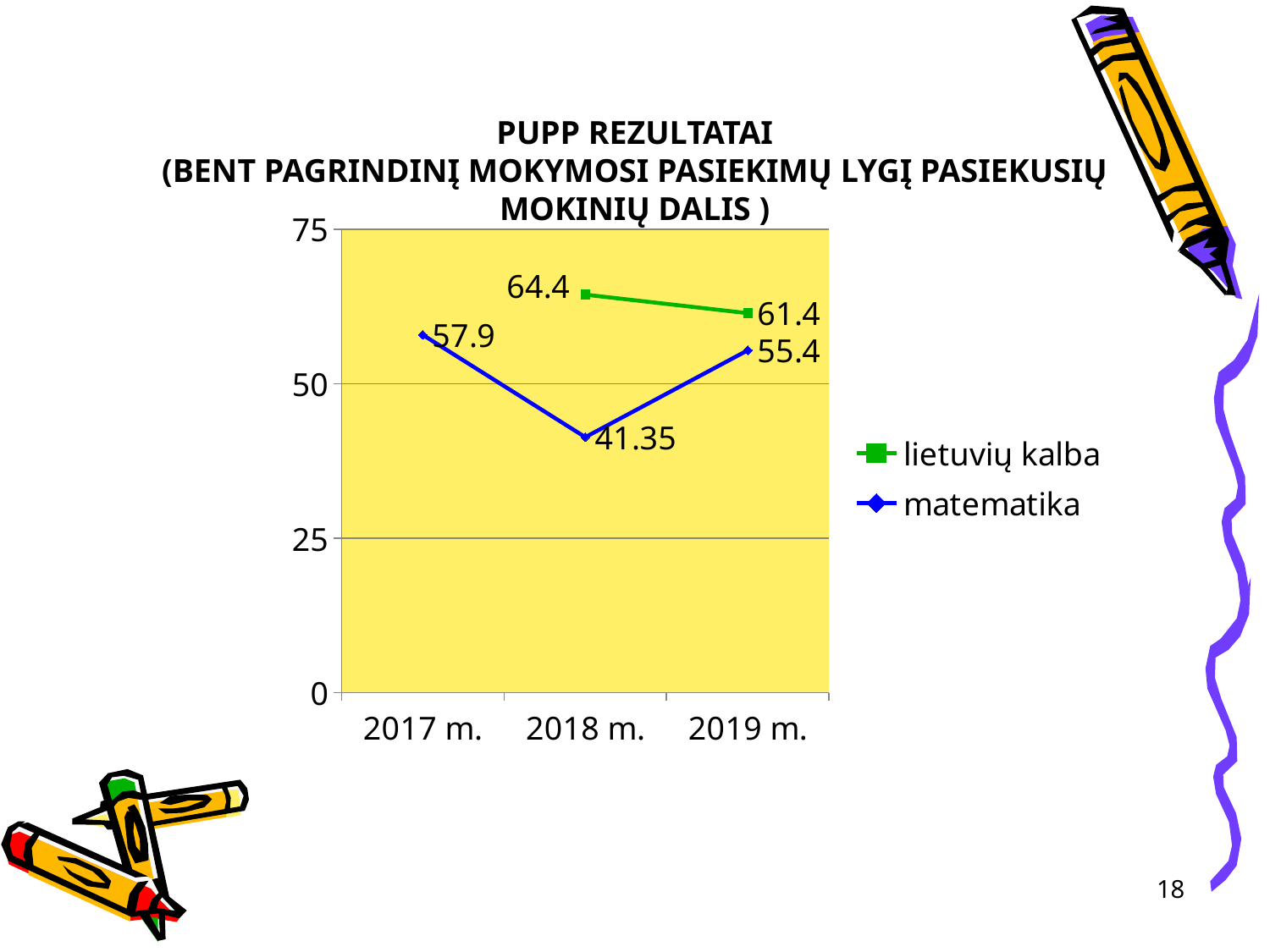
What is the difference between the lietuvių kalba values in 2018 m. and 2019 m.? 3 In which year is the matematika value highest? 2017 m. What is the difference between the matematika values in 2017 m. and 2018 m.? 16.55 Is the value for matematika in 2018 m. greater or less than 50? less What is the value for matematika in 2018 m.? 41.35 What is the value for lietuvių kalba in 2018 m.? 64.4 What kind of chart is shown on the slide? line chart What is the value for matematika in 2017 m.? 57.9 What is the value for lietuvių kalba in 2019 m.? 61.4 In which year is the matematika value lowest? 2018 m. Which series has the larger value in 2019 m., lietuvių kalba or matematika? lietuvių kalba How many series does the legend list? 2